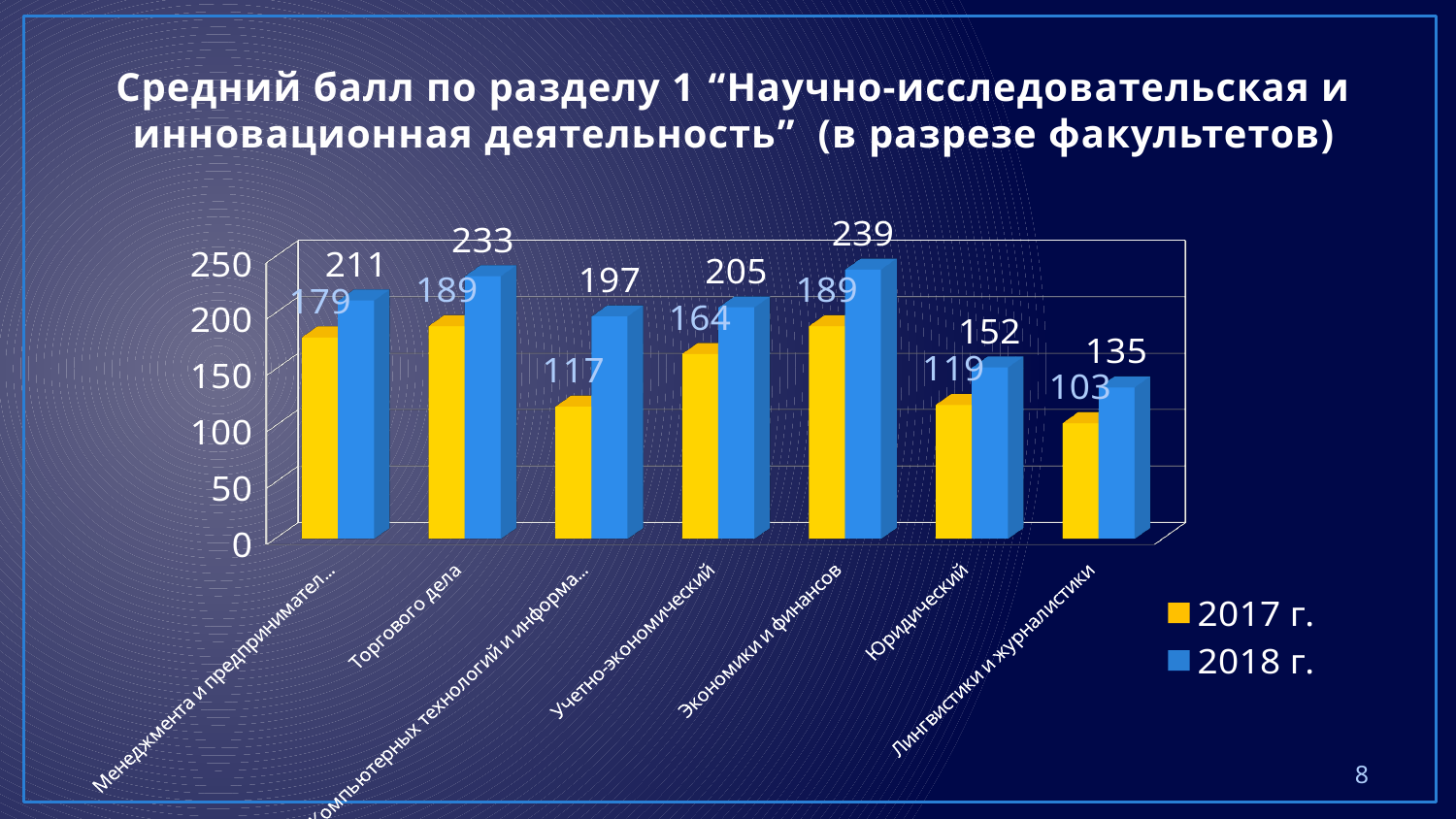
For the Экономики и финансов faculty, how much higher is the 2018 г. value than the 2017 г. value? 50 Which series has the higher value for every faculty shown, 2017 г. or 2018 г.? 2018 г. What is the value for 2017 г. for the Учетно-экономический faculty? 164 How many faculties are shown on the x axis? 7 What kind of chart is shown on the slide? bar chart Which faculty has the highest value for 2018 г.? Экономики и финансов How many series does the legend list? 2 Which faculty has the lowest value for 2017 г.? Лингвистики и журналистики What is the value for 2017 г. for the Юридический faculty? 119 Which is larger: the 2018 г. value for Учетно-экономический or the 2018 г. value for Юридический? Учетно-экономический What is the value for 2018 г. for the Торгового дела faculty? 233 For the Лингвистики и журналистики faculty, what is the difference between the 2018 г. and 2017 г. values? 32